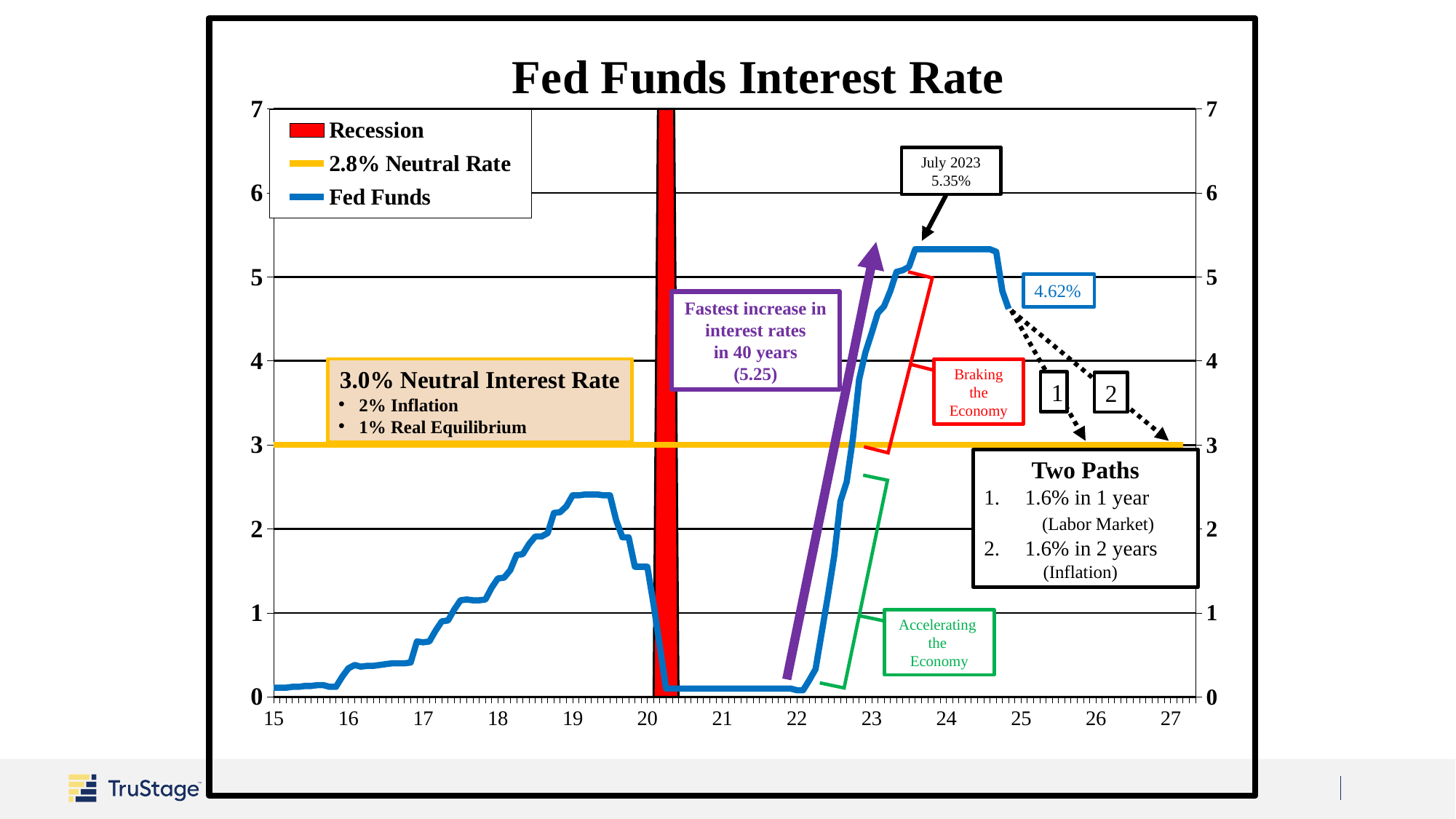
What is the title of the chart? Fed Funds Interest Rate What Fed Funds rate is labeled for July 2023? 5.35% Is the Fed Funds rate at the start of 2024 greater or less than 5? greater What kind of chart is shown on the slide? line chart What is the difference between the July 2023 rate of 5.35% and the labeled 4.62% rate? 0.73% Which is higher, the Fed Funds rate in 2019 or in 2024? 2024 Is the Fed Funds rate at the start of 2021 greater or less than 1? less Is the peak Fed Funds rate in 2019 greater or less than 2? greater What neutral rate is stated in the legend? 2.8% Neutral Rate What value is shown in the blue label near the end of the Fed Funds line, around 2025? 4.62% Does the Fed Funds line rise or fall between 2022 and 2023? rise How many entries does the chart's legend list? 3